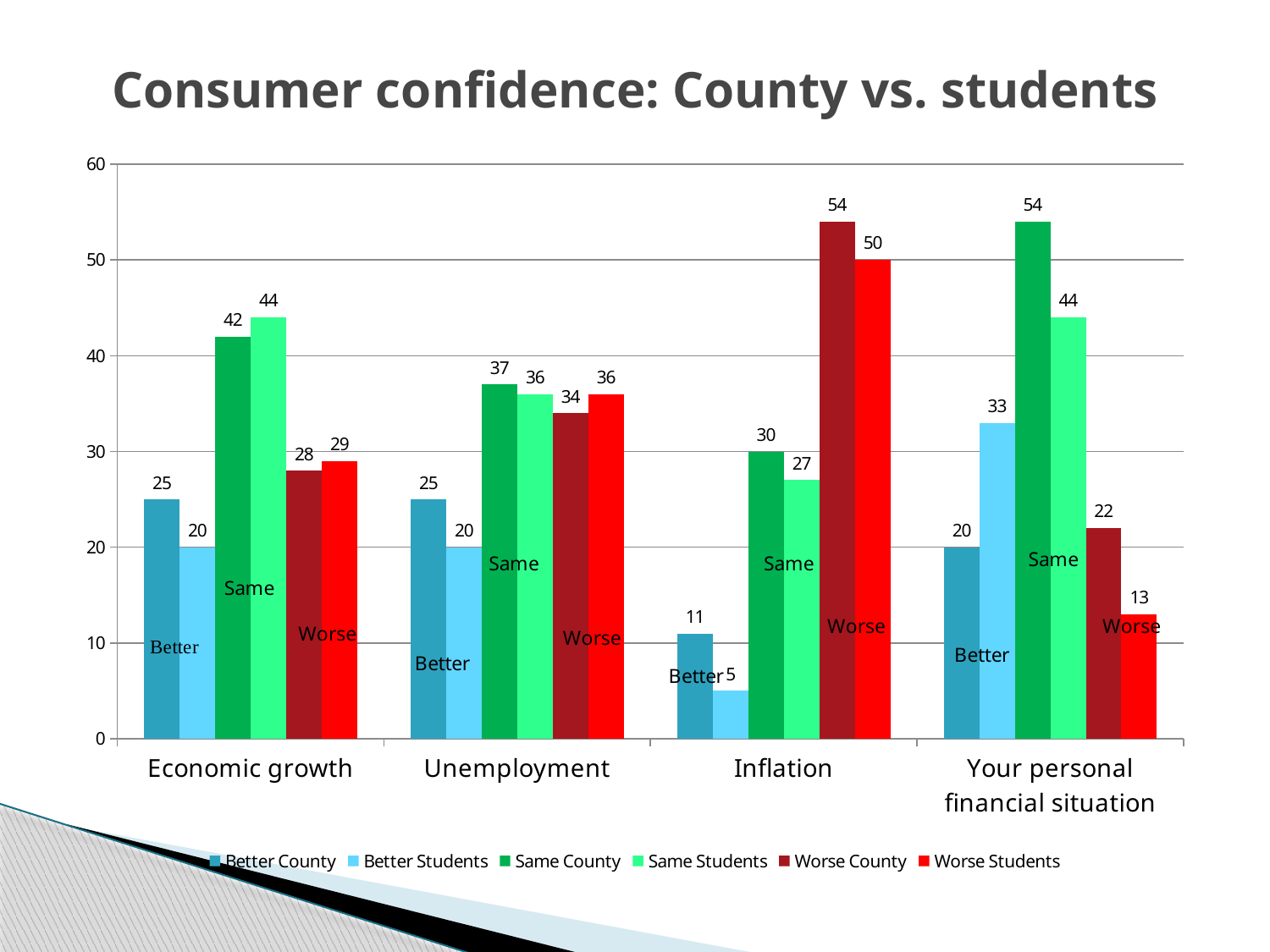
What is the value for Better Students in the Inflation category? 5 What is the title of the chart? Consumer confidence: County vs. students How many series does the legend list? 6 Which series has the highest value in the Your personal financial situation category? Same County What is the value for Worse County in the Inflation category? 54 What kind of chart is shown on the slide? Bar chart Which series has the lowest value in the Inflation category? Better Students What is the value for Better Students in the Your personal financial situation category? 33 What is the difference between Worse County and Worse Students in the Inflation category? 4 Which is larger in the Unemployment category: Same County or Worse County? Same County How many categories are shown on the x axis? 4 What is the value for Same Students in the Economic growth category? 44